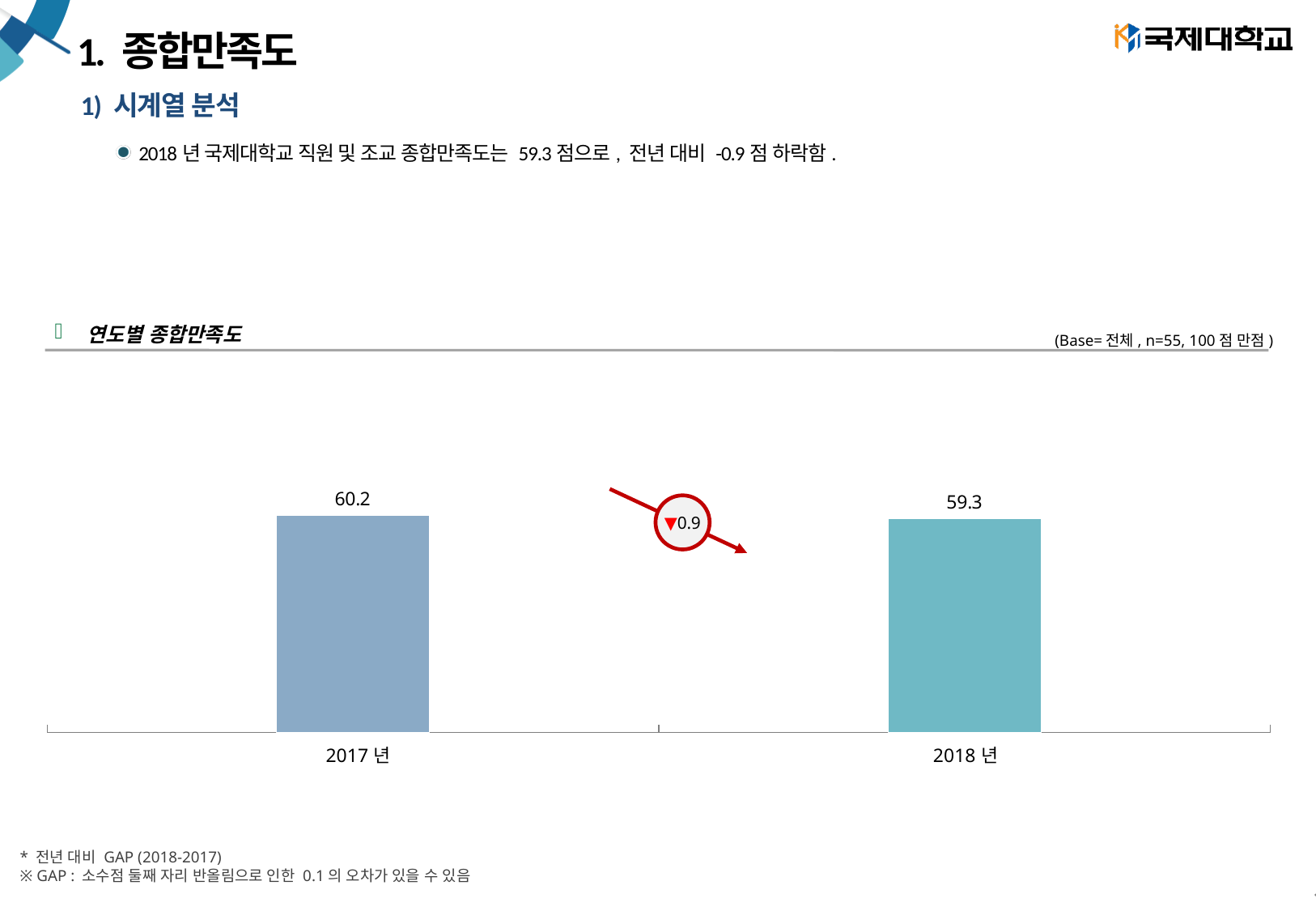
How many bars are shown in the chart? 2 Which year has the higher value? 2017년 What is the title of the chart? 연도별 종합만족도 Do the values rise or fall from 2017년 to 2018년? fall What change is shown in the circled annotation between the two bars? ▼0.9 What kind of chart is shown? bar chart Which year has the lower value? 2018년 What is the difference between the 2017년 and 2018년 values? 0.9 Is the value for 2017년 larger or smaller than the value for 2018년? larger What is the value for 2017년? 60.2 What is the value for 2018년? 59.3